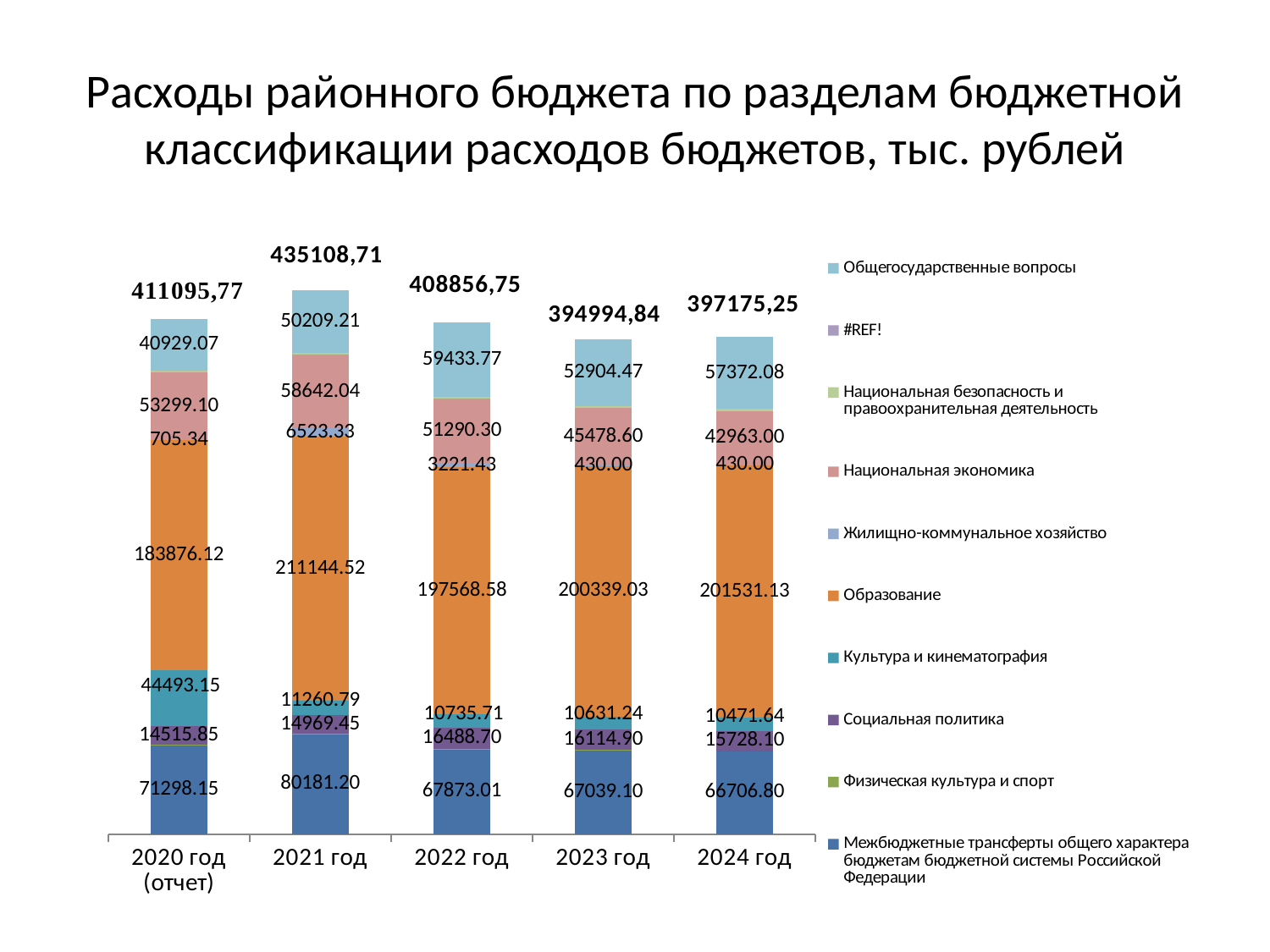
What is the value of Образование for 2022 год? 197568.58 What colour represents Образование in the legend? orange How many series does the legend list? 10 Which year has the highest total expenditure? 2021 год What is the total printed above the bar for 2021 год? 435108,71 What is the value of Межбюджетные трансферты общего характера бюджетам бюджетной системы Российской Федерации for 2020 год (отчет)? 71298.15 What kind of chart is shown on the slide? stacked bar chart What is the value of Общегосударственные вопросы for 2024 год? 57372.08 Which is larger: Национальная экономика in 2021 год or in 2024 год? 2021 год What is the difference between the Образование values for 2021 год and 2020 год (отчет)? 27268.40 How many years (categories) are shown on the x axis? 5 Which year has the lowest total expenditure? 2023 год